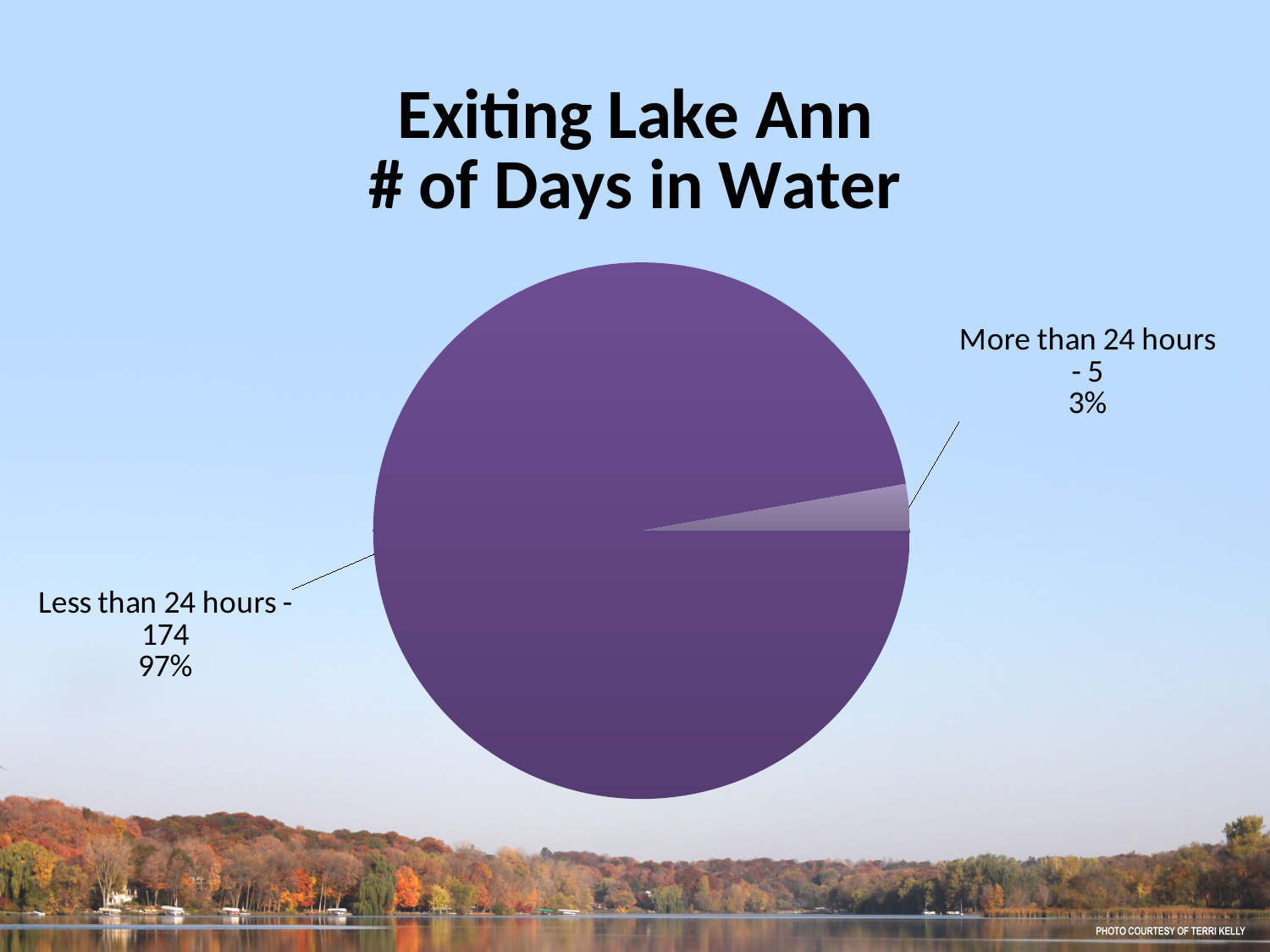
What is the value for "Less than 24 hours"? 174 What is the value for "More than 24 hours"? 5 What is the total of the two values shown in the pie chart? 179 How many slices does the pie chart have? 2 What share of the pie does "More than 24 hours" represent? 3% Which category has the largest slice? Less than 24 hours What is the difference between the values for "Less than 24 hours" and "More than 24 hours"? 169 What is the title of the chart? Exiting Lake Ann # of Days in Water Which is larger, the value for "Less than 24 hours" or "More than 24 hours"? Less than 24 hours What kind of chart is shown on the slide? pie chart What share of the pie does "Less than 24 hours" represent? 97% Which category has the smallest slice? More than 24 hours